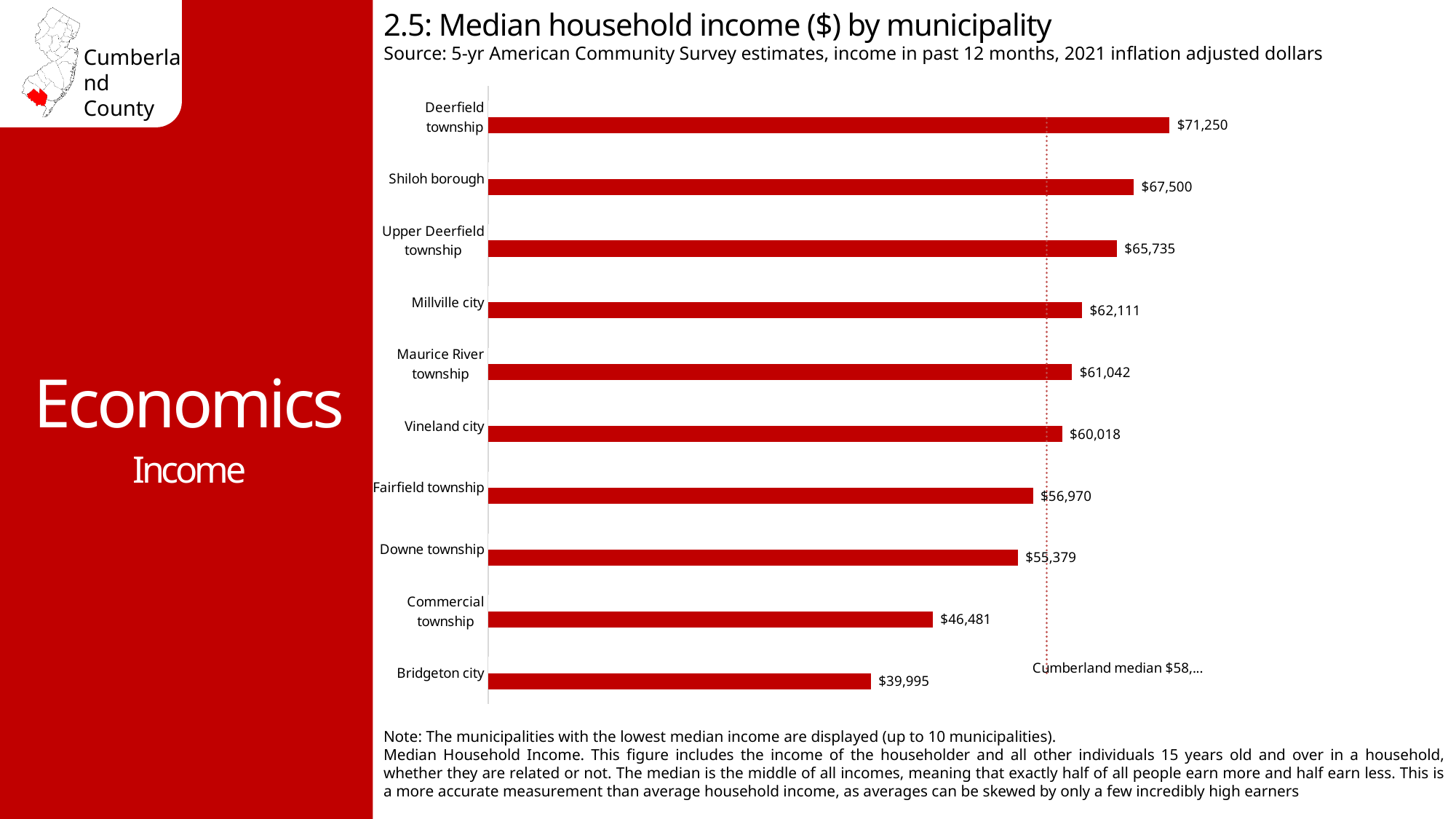
Which has a higher median household income, Millville city or Vineland city? Millville city Which municipality has the highest median household income on the chart? Deerfield township What is the median household income for Vineland city? $60,018 What is the median household income for Bridgeton city? $39,995 What is the median household income for Deerfield township? $71,250 What is the difference in median household income between Shiloh borough and Upper Deerfield township? $1,765 How many municipalities are shown on the chart? 10 Which municipality has the lowest median household income on the chart? Bridgeton city What is the median household income for Commercial township? $46,481 What is the difference in median household income between Deerfield township and Bridgeton city? $31,255 What is the title of the chart? 2.5: Median household income ($) by municipality What type of chart is used to show median household income by municipality? Bar chart